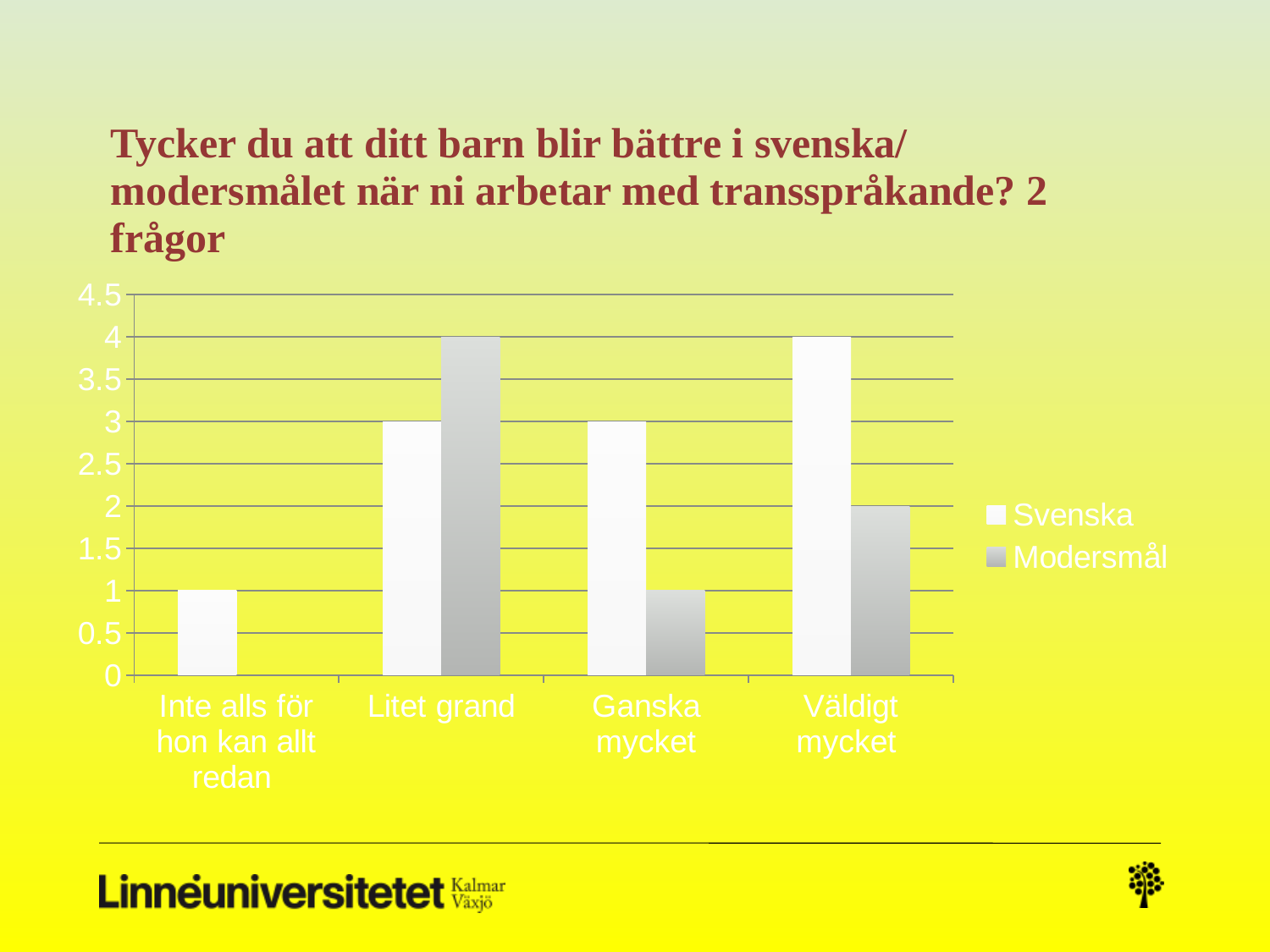
What is the value for Modersmål in the category "Ganska mycket"? 1 In the category "Väldigt mycket", which series has the larger value, Svenska or Modersmål? Svenska What is the difference between the Svenska and Modersmål values in the category "Ganska mycket"? 2 What is the value for Svenska in the category "Litet grand"? 3 What is the value for Modersmål in the category "Litet grand"? 4 How many series does the legend list? 2 Which category has the highest value for Modersmål? Litet grand How many categories are shown on the x axis? 4 What is the value for Svenska in the category "Väldigt mycket"? 4 Which category has the highest value for Svenska? Väldigt mycket What kind of chart is shown on the slide? bar chart Which series is shown in the darker grey bars according to the legend? Modersmål